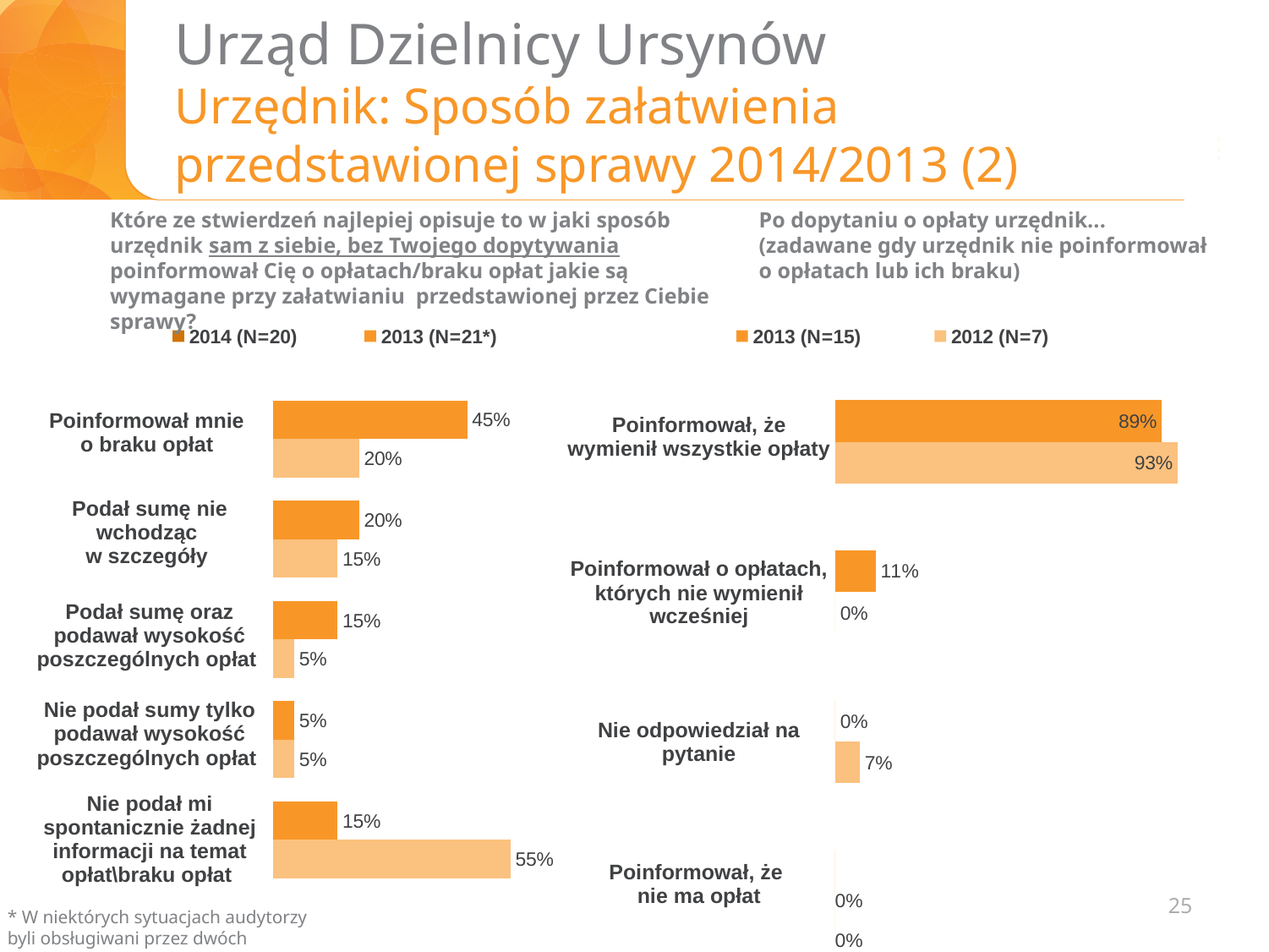
In the left chart, what is the 2013 (N=21*) value for "Nie podał mi spontanicznie żadnej informacji na temat opłat\braku opłat"? 55% In the right chart, what is the 2012 (N=7) value for "Poinformował, że wymienił wszystkie opłaty"? 93% What type of chart is the right chart? Bar chart In the left chart, what is the difference between the 2014 and 2013 values for "Poinformował mnie o braku opłat"? 25 percentage points In the right chart, what is the 2013 (N=15) value for "Poinformował o opłatach, których nie wymienił wcześniej"? 11% How many series does the legend of the left chart list? 2 How many categories does the left chart show? 5 In the left chart, which is larger for "Podał sumę oraz podawał wysokość poszczególnych opłat": the 2014 value or the 2013 value? 2014 In the right chart, what is the difference between the 2012 and 2013 values for "Poinformował, że wymienił wszystkie opłaty"? 4 percentage points In the left chart, which category has the highest 2013 (N=21*) value? Nie podał mi spontanicznie żadnej informacji na temat opłat\braku opłat In the right chart, what is the 2012 (N=7) value for "Nie odpowiedział na pytanie"? 7% In the left chart, what is the 2014 (N=20) value for "Poinformował mnie o braku opłat"? 45%